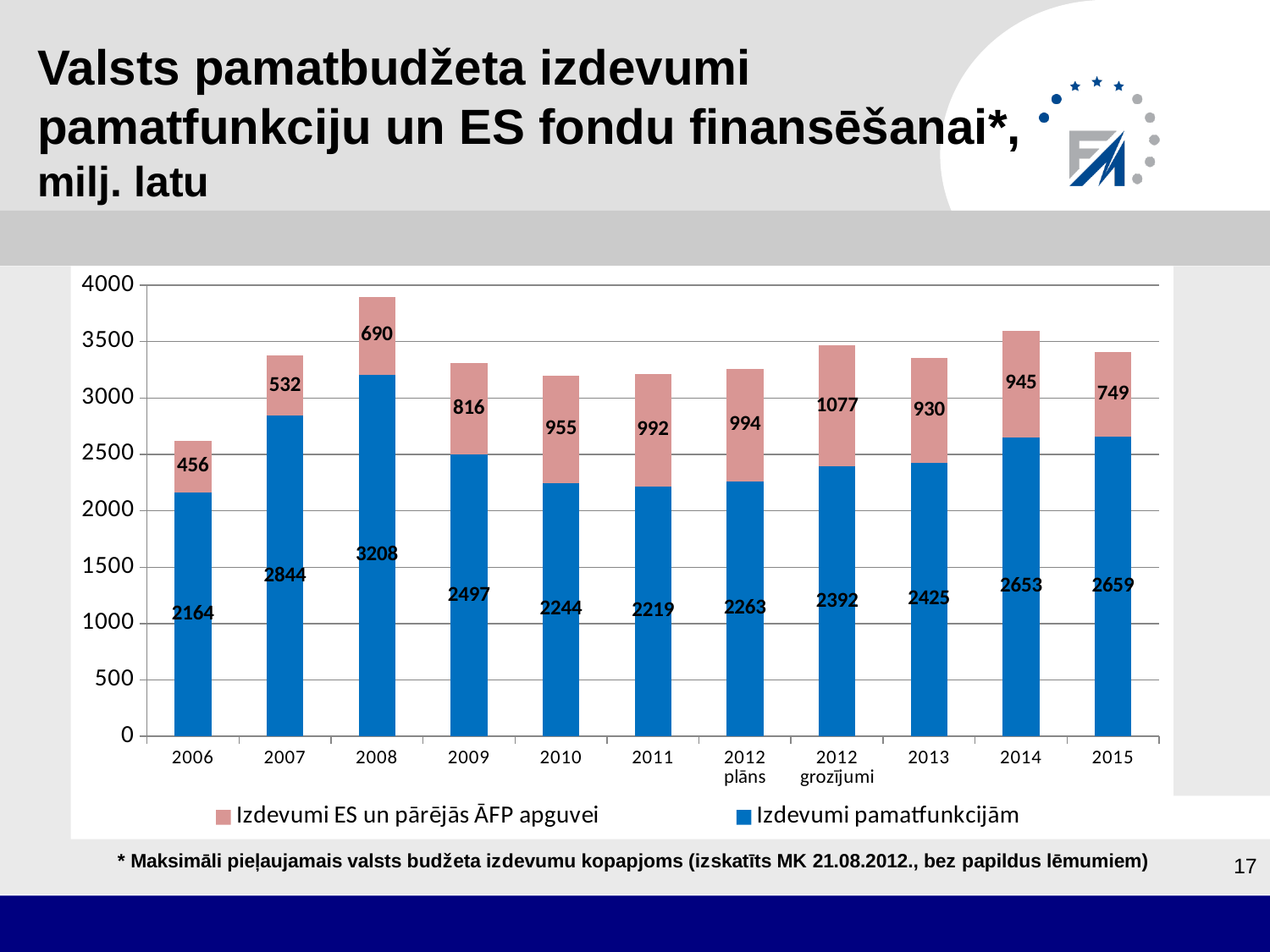
Which is larger: Izdevumi ES un pārējās ĀFP apguvei for 2011 or for 2015? 2011 What is the value of Izdevumi pamatfunkcijām for 2015? 2659 Which category has the highest value for Izdevumi pamatfunkcijām? 2008 What is the difference between the Izdevumi pamatfunkcijām values for 2014 and 2013? 228 Which category has the lowest value for Izdevumi ES un pārējās ĀFP apguvei? 2006 What is the value of Izdevumi ES un pārējās ĀFP apguvei for 2012 grozījumi? 1077 How many categories are shown on the x axis? 11 How many series does the legend list? 2 What kind of chart is shown on the slide? Stacked bar chart What is the total of the stacked bar for 2008? 3898 What is the value of Izdevumi pamatfunkcijām for 2008? 3208 What is the total of the stacked bar for 2006? 2620